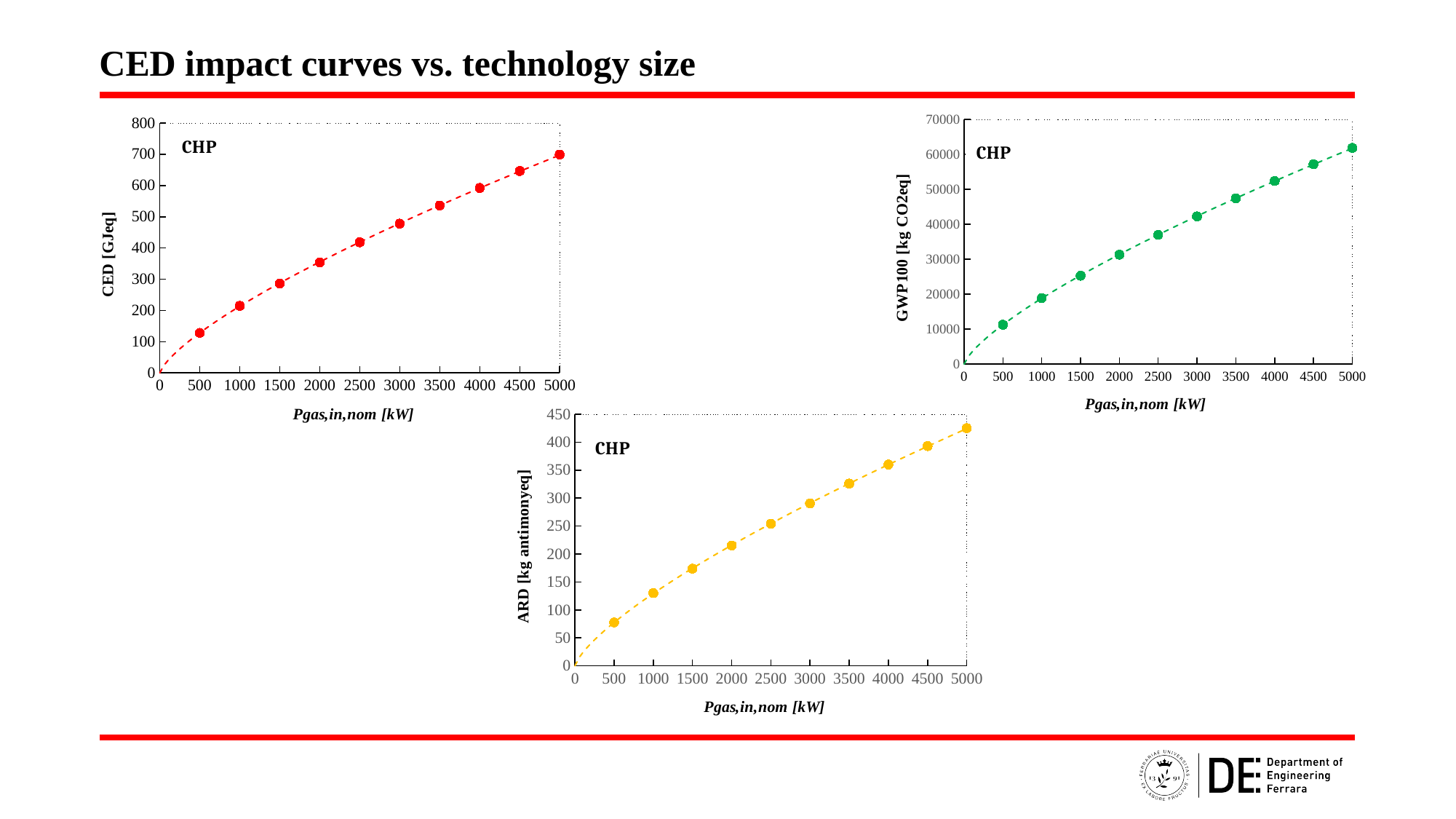
In the top-right chart (GWP100 [kg CO2eq]), is the value at 3000 kW greater or less than 40000? greater In the bottom chart (ARD [kg antimonyeq]), at which Pgas,in,nom value is the plotted value lowest? 500 In the top-left chart (CED [GJeq]), how many data points are plotted? 10 What is the x-axis label of the bottom chart (ARD [kg antimonyeq])? Pgas,in,nom [kW] In the top-right chart (GWP100 [kg CO2eq]), is the value at 5000 kW greater or less than 60000? greater In the bottom chart (ARD [kg antimonyeq]), is the value at 500 kW greater or less than 100? less In the top-left chart (CED [GJeq]), do the values rise or fall as Pgas,in,nom increases? rise What kind of chart is the top-left chart (CED [GJeq])? scatter chart In the top-right chart (GWP100 [kg CO2eq]), at which Pgas,in,nom value is the plotted value highest? 5000